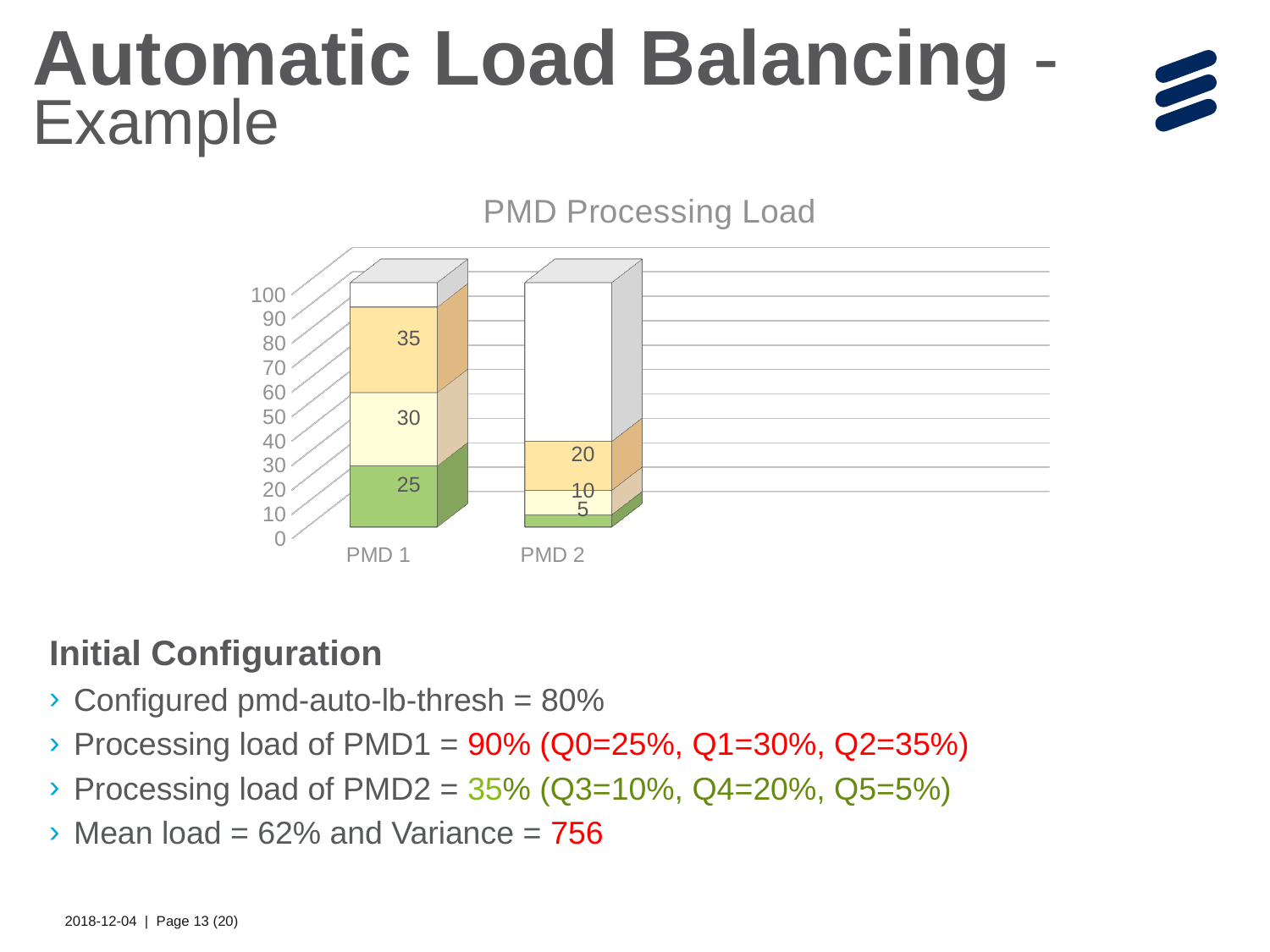
How many categories are shown on the x axis of the chart? 2 What is the largest labeled segment value in the chart? 35 What is the total of the labeled segments in the PMD 1 bar? 90 What is the value of the middle light-yellow segment of the PMD 1 bar? 30 What is the difference between the green segment of PMD 1 and the green segment of PMD 2? 20 What kind of chart is shown on the slide? Stacked bar chart Which bar has the larger total of labeled segments, PMD 1 or PMD 2? PMD 1 What is the value of the bottom green segment of the PMD 2 bar? 5 What is the value of the orange segment of the PMD 2 bar? 20 What is the value of the bottom green segment of the PMD 1 bar? 25 What is the title of the chart? PMD Processing Load What is the total of the labeled segments in the PMD 2 bar? 35